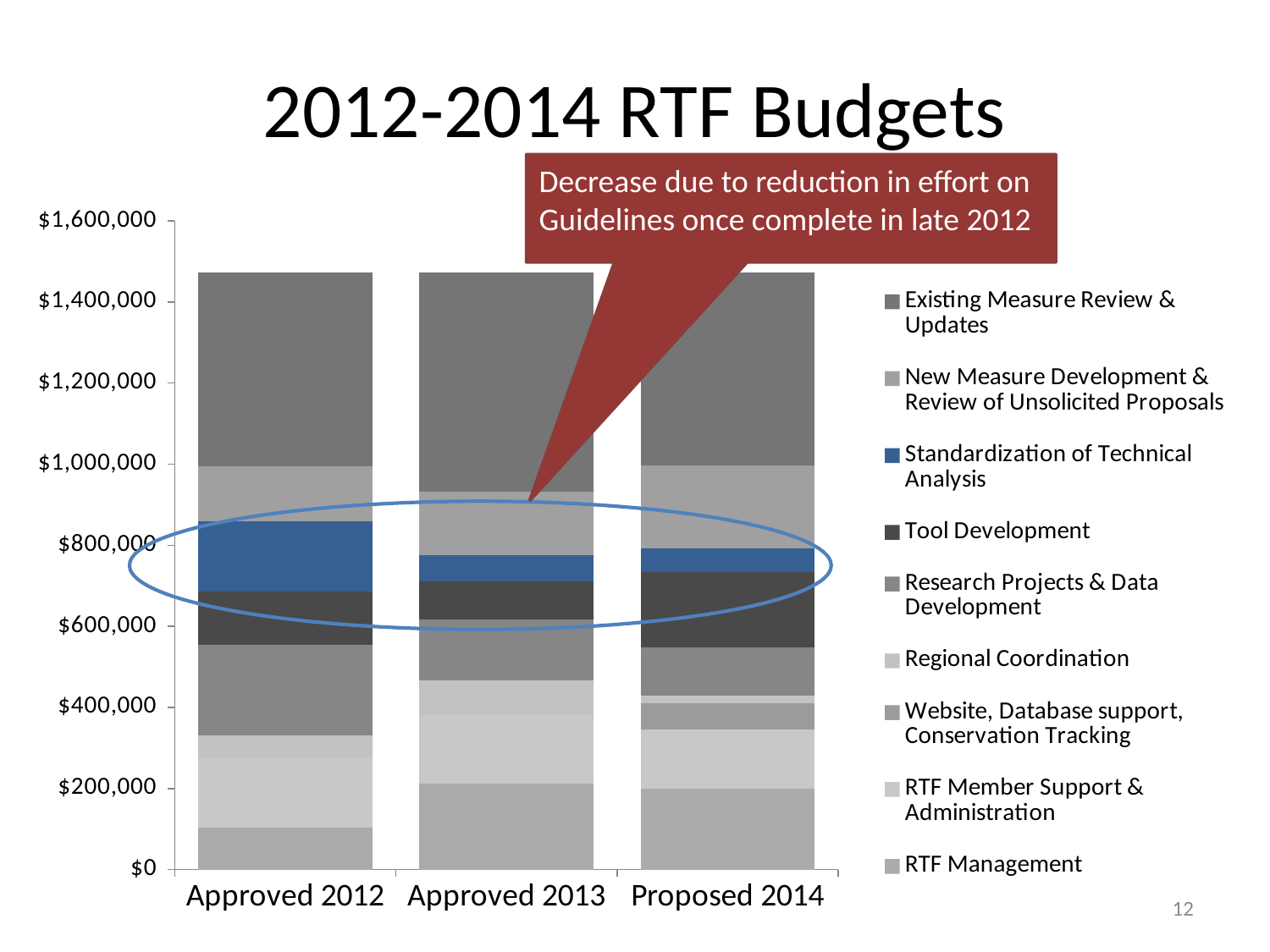
Is the total budget for Approved 2013 greater or less than $1,600,000? less What does the red callout on the chart say? Decrease due to reduction in effort on Guidelines once complete in late 2012 Which year has the largest Standardization of Technical Analysis segment? Approved 2012 Is the total budget for Approved 2012 greater or less than $1,400,000? greater Is the total budget for Proposed 2014 greater or less than $1,200,000? greater What kind of chart is shown on the slide? stacked bar chart Is the Standardization of Technical Analysis segment larger for Approved 2012 or Approved 2013? Approved 2012 What is the title of the chart? 2012-2014 RTF Budgets Which series is shown in blue in the stacked bars? Standardization of Technical Analysis How many budget years (categories) are shown on the x axis? 3 How many series does the legend list? 9